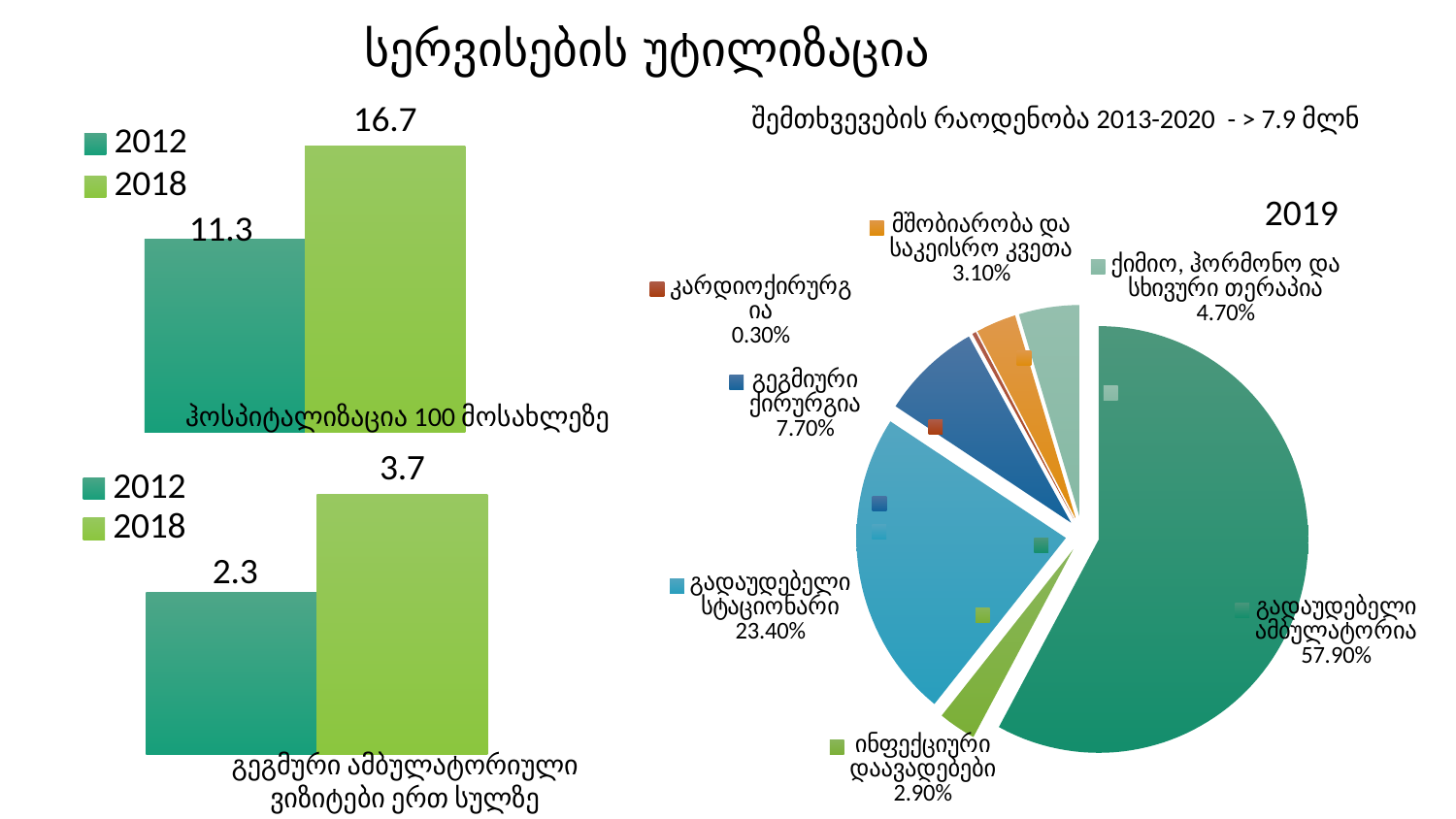
How many series does the legend of the top-left bar chart list? 2 In the 2019 pie chart, what is the share for გეგმიური ქირურგია? 7.70% In the 2019 pie chart, which category has the smallest share? კარდიოქირურგია In the top-left bar chart (ჰოსპიტალიზაცია 100 მოსახლეზე), what is the difference between the 2018 and 2012 values? 5.4 In the bottom-left bar chart (გეგმური ამბულატორიული ვიზიტები ერთ სულზე), what is the value for 2012? 2.3 In the bottom-left bar chart (გეგმური ამბულატორიული ვიზიტები ერთ სულზე), what is the value for 2018? 3.7 What kind of chart is the chart on the right side of the slide (2019)? Pie chart In the bottom-left bar chart (გეგმური ამბულატორიული ვიზიტები ერთ სულზე), which year has the larger value, 2012 or 2018? 2018 In the top-left bar chart (ჰოსპიტალიზაცია 100 მოსახლეზე), what is the value for 2012? 11.3 In the 2019 pie chart, what share does გადაუდებელი ამბულატორია have? 57.90% In the top-left bar chart (ჰოსპიტალიზაცია 100 მოსახლეზე), what is the value for 2018? 16.7 How many slices does the 2019 pie chart have? 7